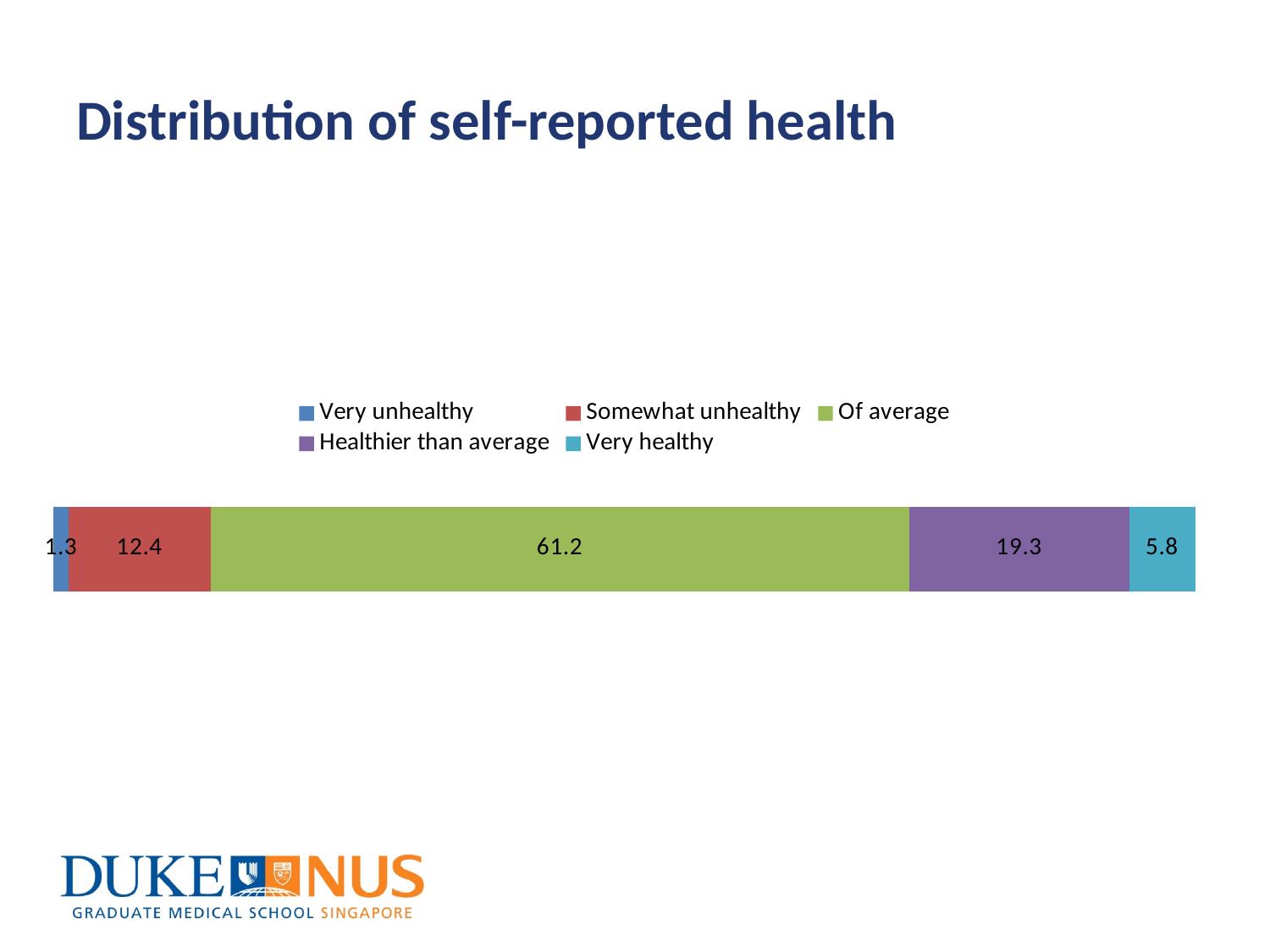
What is the value for Healthier than average? 19.3 Which category has the lowest value? Very unhealthy Which is larger, the value for Very healthy or the value for Somewhat unhealthy? Somewhat unhealthy What kind of chart is shown on the slide? Stacked bar chart What is the title of the slide containing the chart? Distribution of self-reported health What is the value for Very unhealthy? 1.3 Which category has the highest value? Of average What is the value for Of average? 61.2 What is the difference between the values for Healthier than average and Somewhat unhealthy? 6.9 What is the value for Very healthy? 5.8 How many series does the legend list? 5 What is the value for Somewhat unhealthy? 12.4